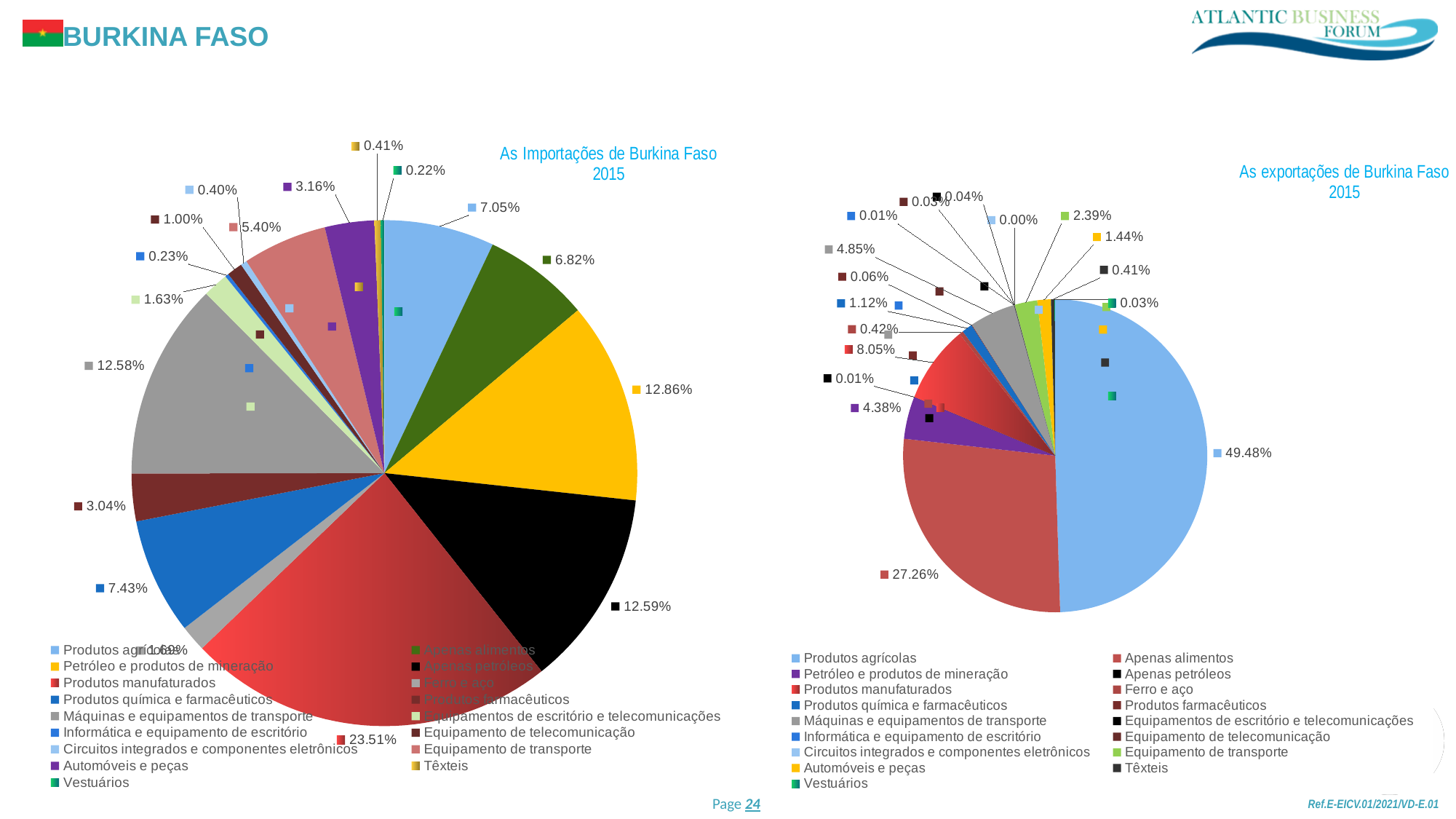
What kind of chart is used for 'As Importações de Burkina Faso 2015'? pie chart In the 'As exportações de Burkina Faso 2015' chart, what is the difference between the Produtos agrícolas share and the Apenas alimentos share? 22.22% In the 'As Importações de Burkina Faso 2015' chart, what is the share for Produtos manufaturados? 23.51% How many entries does the legend of the 'As exportações de Burkina Faso 2015' chart list? 17 In the 'As Importações de Burkina Faso 2015' chart, what is the difference between the Produtos agrícolas share and the Apenas alimentos share? 0.23% In the 'As exportações de Burkina Faso 2015' chart, which is larger: Produtos manufaturados or Máquinas e equipamentos de transporte? Produtos manufaturados In the 'As Importações de Burkina Faso 2015' chart, which is larger: Produtos química e farmacêuticos or Equipamento de transporte? Produtos química e farmacêuticos In the 'As exportações de Burkina Faso 2015' chart, what is the share for Apenas alimentos? 27.26% In the 'As Importações de Burkina Faso 2015' chart, what is the share for Petróleo e produtos de mineração? 12.86% In the 'As Importações de Burkina Faso 2015' chart, which category has the largest slice? Produtos manufaturados In the 'As exportações de Burkina Faso 2015' chart, what is the share for Produtos agrícolas? 49.48% In the 'As exportações de Burkina Faso 2015' chart, which category has the largest slice? Produtos agrícolas